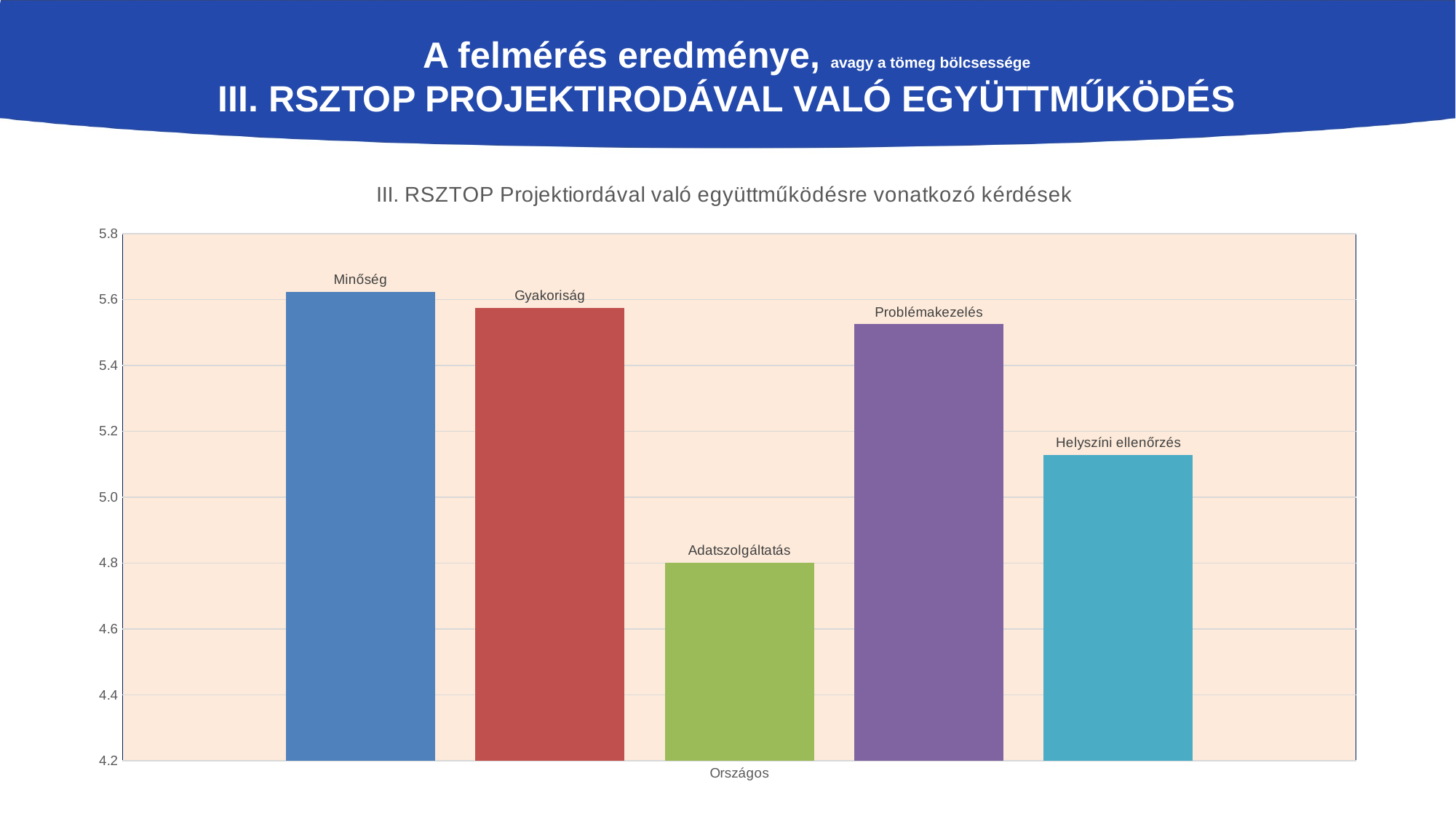
Is the value for Gyakoriság greater or less than 5.6? less Is the value for Adatszolgáltatás greater or less than 5.0? less Which category has the lowest bar in the chart? Adatszolgáltatás Is the value for Helyszíni ellenőrzés greater or less than 5.0? greater What is the title of the chart? III. RSZTOP Projektiordával való együttműködésre vonatkozó kérdések Which is larger, the value for Problémakezelés or the value for Helyszíni ellenőrzés? Problémakezelés How many bars are plotted in the chart? 5 Which category has the highest bar in the chart? Minőség What kind of chart is shown on the slide? bar chart Which is larger, the value for Gyakoriság or the value for Adatszolgáltatás? Gyakoriság